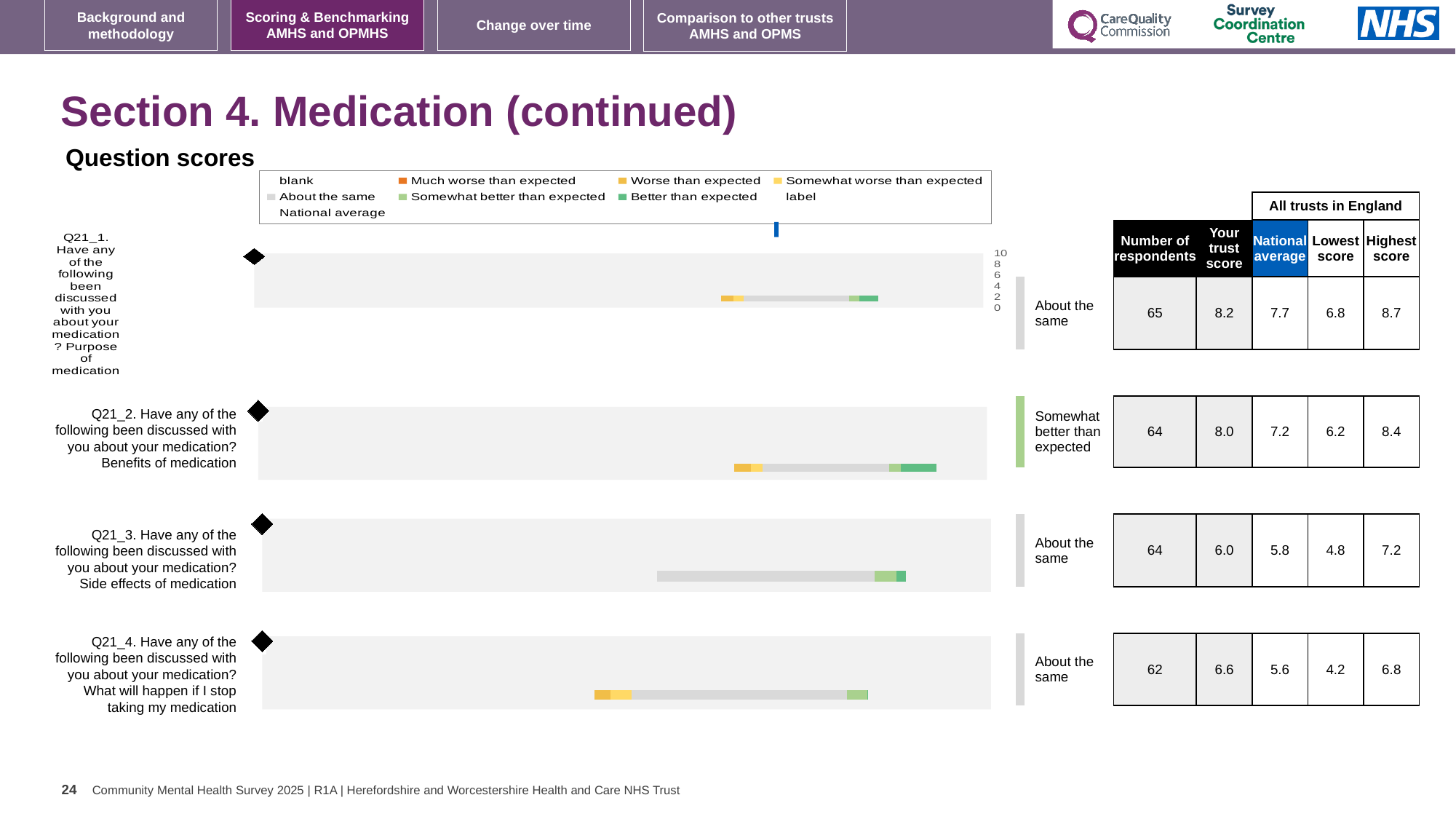
By how much does the trust score for Q21_1 exceed the national average for Q21_1? 0.5 What is the national average for Q21_3 (Side effects of medication)? 5.8 For Q21_4, which is larger: the trust score or the national average? The trust score (6.6) How many respondents are shown for Q21_1 (Purpose of medication)? 65 What is the lowest score across all trusts in England for Q21_2 (Benefits of medication)? 6.2 Which question has the lowest trust score on this slide? Q21_3 (Side effects of medication) What is the highest score across all trusts in England for Q21_4 (What will happen if I stop taking my medication)? 6.8 What benchmark category is shown for Q21_2 (Benefits of medication)? Somewhat better than expected What is the trust score for Q21_2 (Benefits of medication)? 8.0 What kind of chart is used to show the question scores? Bar chart Which question has the highest trust score on this slide? Q21_1 (Purpose of medication) How many question scores are plotted on this slide? 4